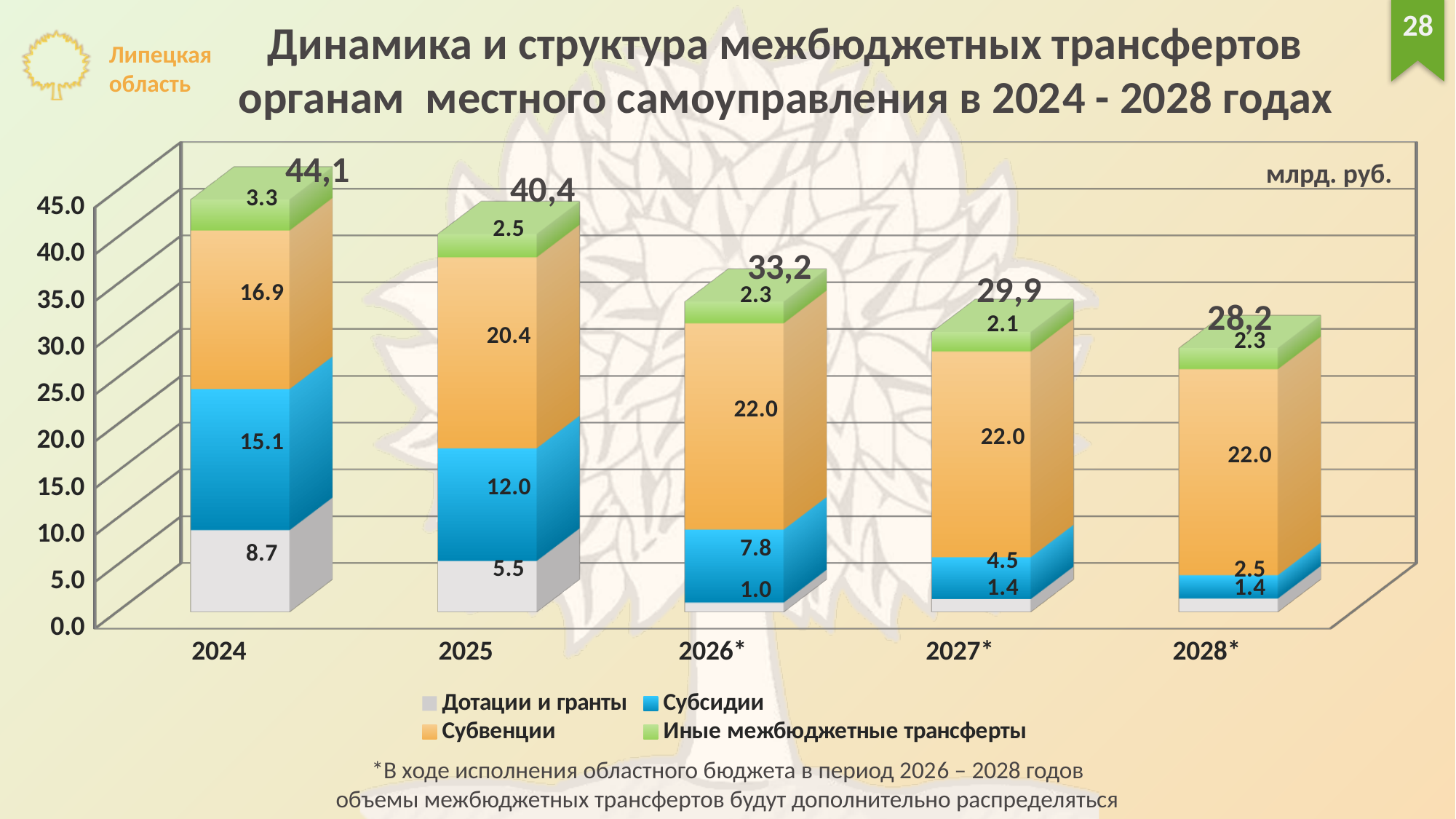
Which year has the lowest value for Субсидии? 2028* What is the value of Субвенции for 2025? 20.4 Do the total values rise or fall from 2024 to 2028*? fall What is the total of the stacked bar for 2028*? 28,2 Which year has the highest total of intergovernmental transfers? 2024 How many years are shown on the x axis? 5 What is the difference between the Субсидии values for 2024 and 2025? 3.1 What is the value of Субсидии for 2024? 15.1 What is the value of Дотации и гранты for 2026*? 1.0 How many series does the legend list? 4 What is the total of the stacked bar for 2024? 44,1 Which is larger: Дотации и гранты in 2024 or in 2025? 2024